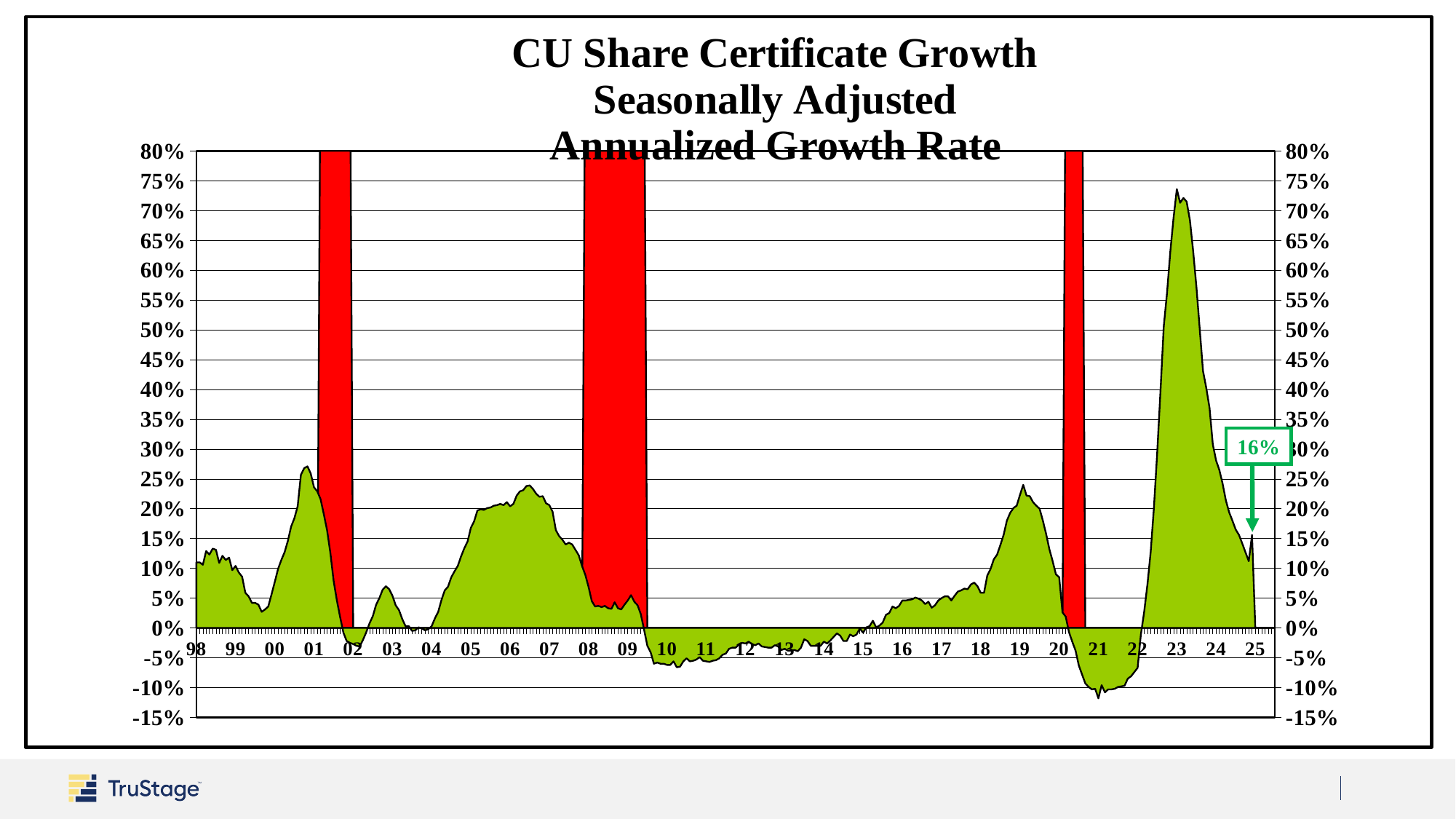
Is the peak growth rate around 2006 greater or less than 20%? greater Is the growth rate in 2010 greater or less than 0%? less What kind of chart is shown on the slide? area chart What is the labeled growth rate value at the end of the series in 2025? 16% How many red shaded bands appear on the chart? 3 Is the peak growth rate around 2001 greater or less than 30%? less Which peak is higher, the one around 2019 or the one around 2023? 2023 In which year does the growth rate reach its highest peak? 23 Does the growth rate rise or fall from 2023 to 2025? fall In which year does the growth rate reach its lowest point? 21